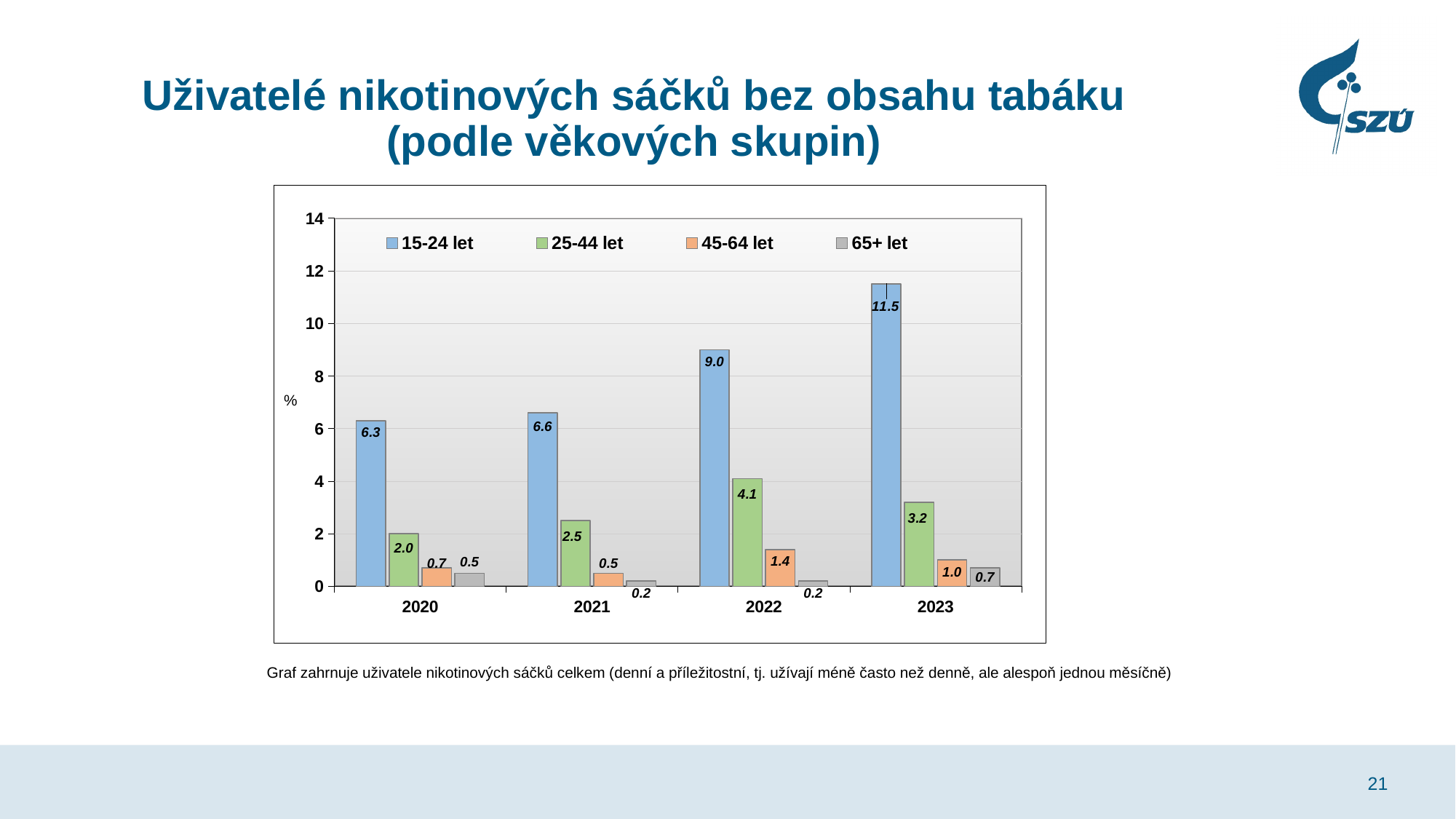
What is the value for the 65+ let series in 2021? 0.2 In which year is the value for the 25-44 let series lowest? 2020 What is the difference between the 15-24 let values in 2023 and 2022? 2.5 What is the value for the 15-24 let series in 2023? 11.5 How many series does the legend list? 4 In which year is the value for the 15-24 let series highest? 2023 What is the value for the 25-44 let series in 2022? 4.1 How many years are shown on the x axis? 4 Which is larger: the 45-64 let value in 2022 or the 45-64 let value in 2023? 2022 Is the value for the 15-24 let series in 2022 greater or less than 8? greater What kind of chart is shown on the slide? bar chart What is the value for the 45-64 let series in 2020? 0.7